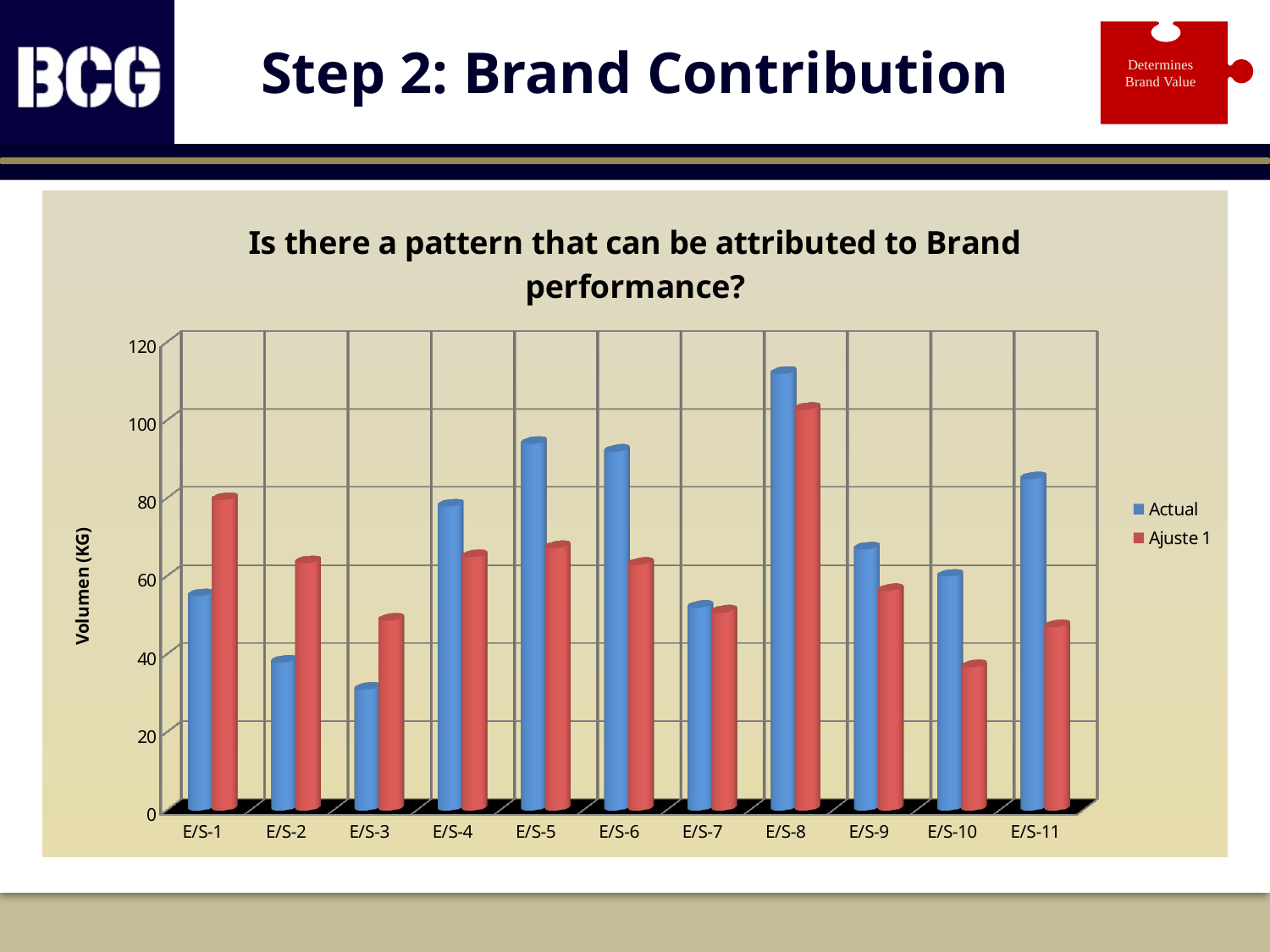
What is the title of the chart's vertical axis? Volumen (KG) Which category has the lowest Ajuste 1 value? E/S-10 For E/S-11, which is larger: the Actual value or the Ajuste 1 value? Actual Which category has the highest Actual value? E/S-8 What kind of chart is shown on the slide? Bar chart How many series does the chart's legend list? 2 Is the Actual value for E/S-3 greater or less than 40? less How many categories are shown along the x axis of the chart? 11 Which category has the highest Ajuste 1 value? E/S-8 Which category has the lowest Actual value? E/S-3 Is the Actual value for E/S-8 greater or less than 100? greater For E/S-1, which is larger: the Actual value or the Ajuste 1 value? Ajuste 1